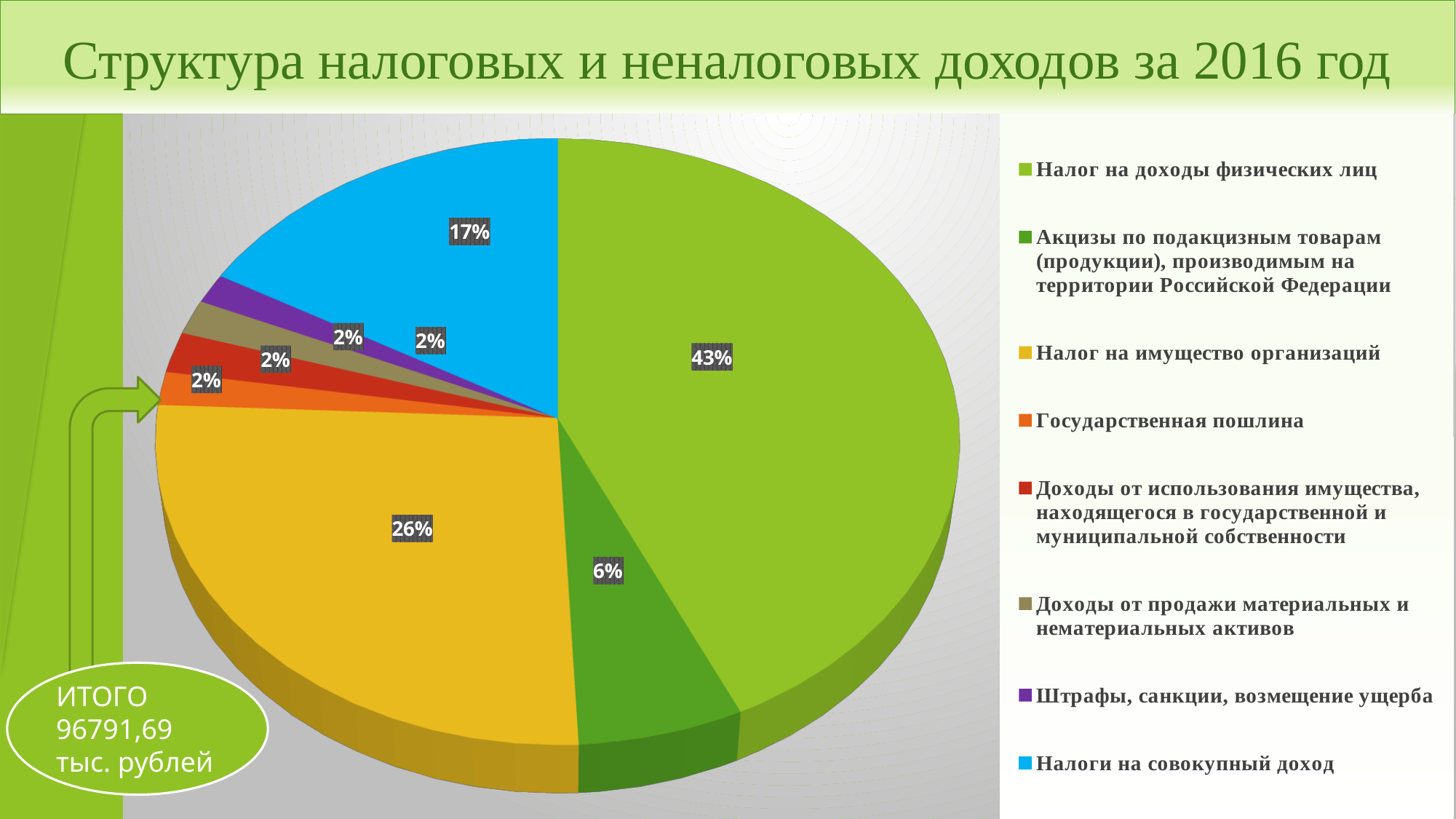
Which category has the largest share of the pie? Налог на доходы физических лиц What share of the pie does "Государственная пошлина" have? 2% What is the title of the chart on the slide? Структура налоговых и неналоговых доходов за 2016 год What share of the pie does "Налоги на совокупный доход" have? 17% Which is larger: the share of "Налоги на совокупный доход" or the share of "Акцизы по подакцизным товарам (продукции), производимым на территории Российской Федерации"? Налоги на совокупный доход What type of chart is shown on the slide? pie chart What share of the pie does "Налог на имущество организаций" have? 26% What total (ИТОГО) is stated on the slide? 96791,69 тыс. рублей What is the difference in percentage points between the shares of "Налог на доходы физических лиц" and "Налог на имущество организаций"? 17 How many categories does the legend list? 8